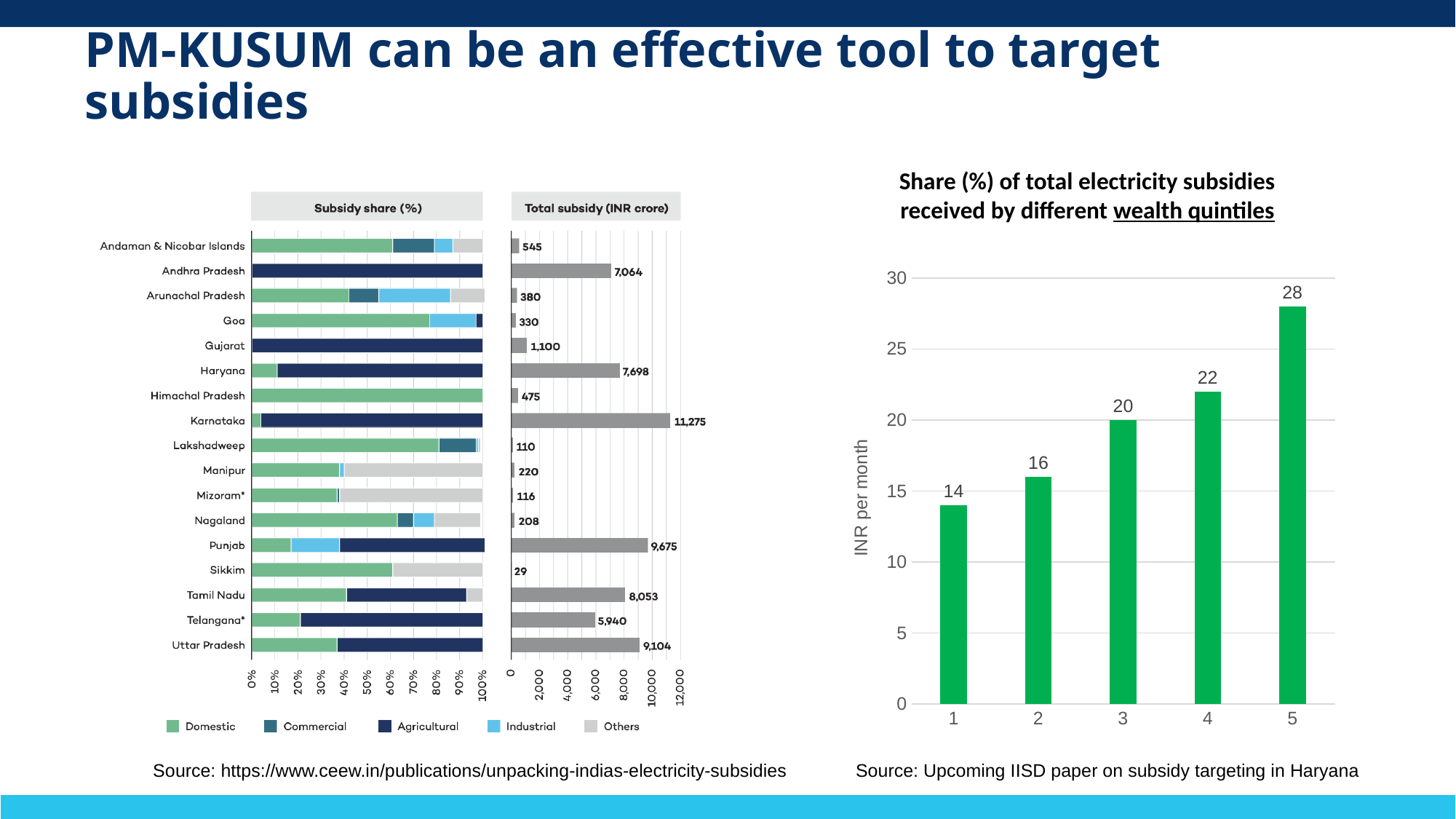
In the left chart, how many series does the legend list? 5 In the chart on the right, which wealth quintile has the highest value? 5 In the left chart, which state has the lowest total subsidy (INR crore)? Sikkim In the chart on the right, what is the value for wealth quintile 5? 28 In the left chart, which state has the highest total subsidy (INR crore)? Karnataka In the chart on the right, what is the label of the vertical axis? INR per month In the chart on the right, do the values rise or fall from quintile 1 to quintile 5? rise In the chart on the right, how many wealth quintiles are plotted? 5 In the chart on the right, what is the difference between the values for quintile 5 and quintile 1? 14 In the left chart, what is the total subsidy (INR crore) for Karnataka? 11,275 In the chart on the right, what is the value for wealth quintile 1? 14 In the left chart, which has a larger total subsidy, Punjab or Uttar Pradesh? Punjab